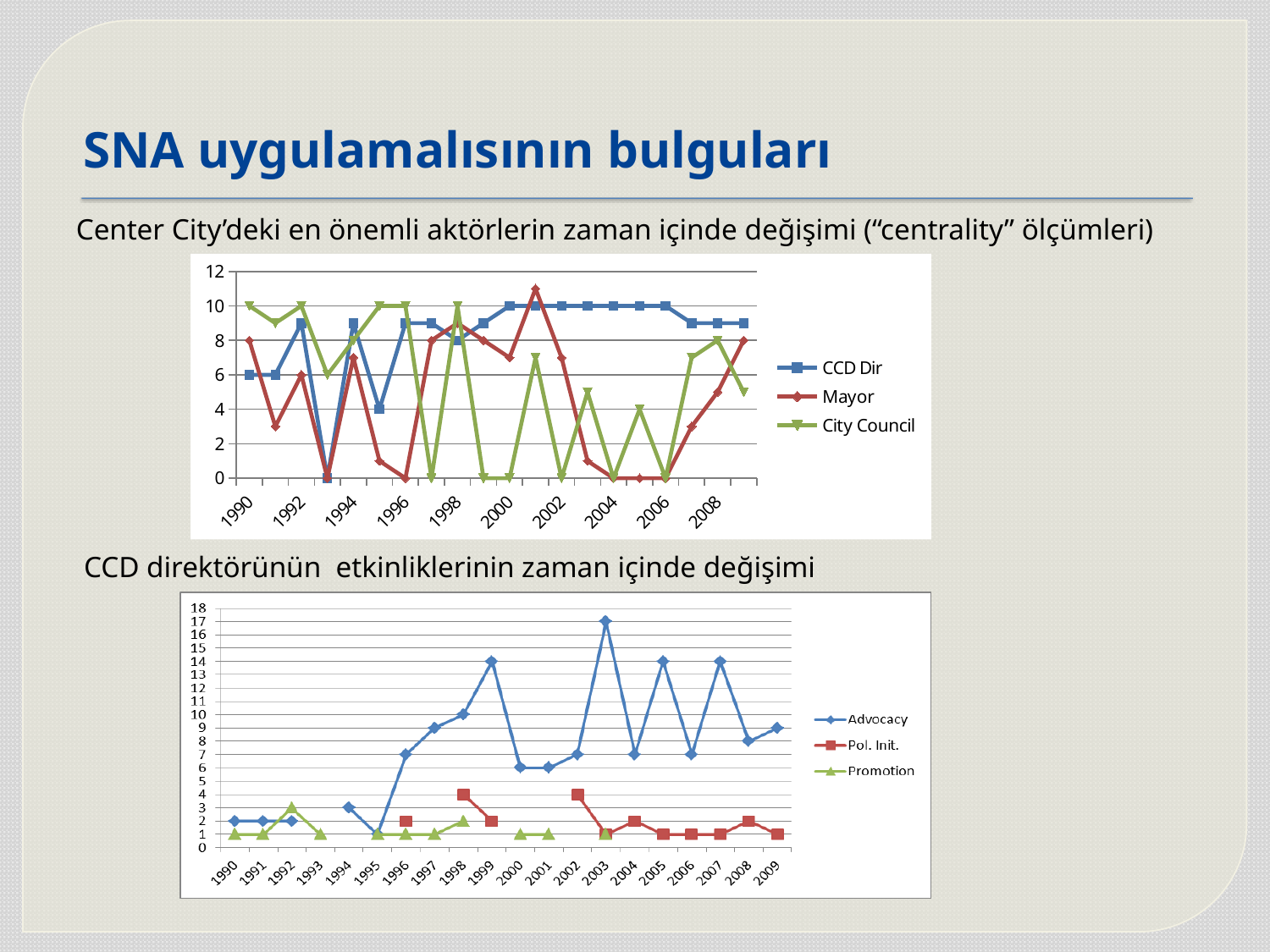
In the top chart, what is the value for Mayor in 1993? 0 In the bottom chart, is the Advocacy value larger in 1999 or in 2000? 1999 How many series does the legend of the bottom chart list? 3 In the top chart, is the value for City Council in 2000 greater or less than 2? less In the bottom chart, what is the difference between the Advocacy values in 2003 and 2004? 10 In the bottom chart, what is the value for Pol. Init. in 1998? 4 In the bottom chart, what is the value for Advocacy in 2003? 17 In the top chart, which series has the highest value in 2001? Mayor In the bottom chart, in which year does Advocacy reach its highest value? 2003 In the top chart, what is the value for CCD Dir in 2000? 10 How many series does the legend of the top chart list? 3 What kind of chart is the top chart on the slide? Line chart